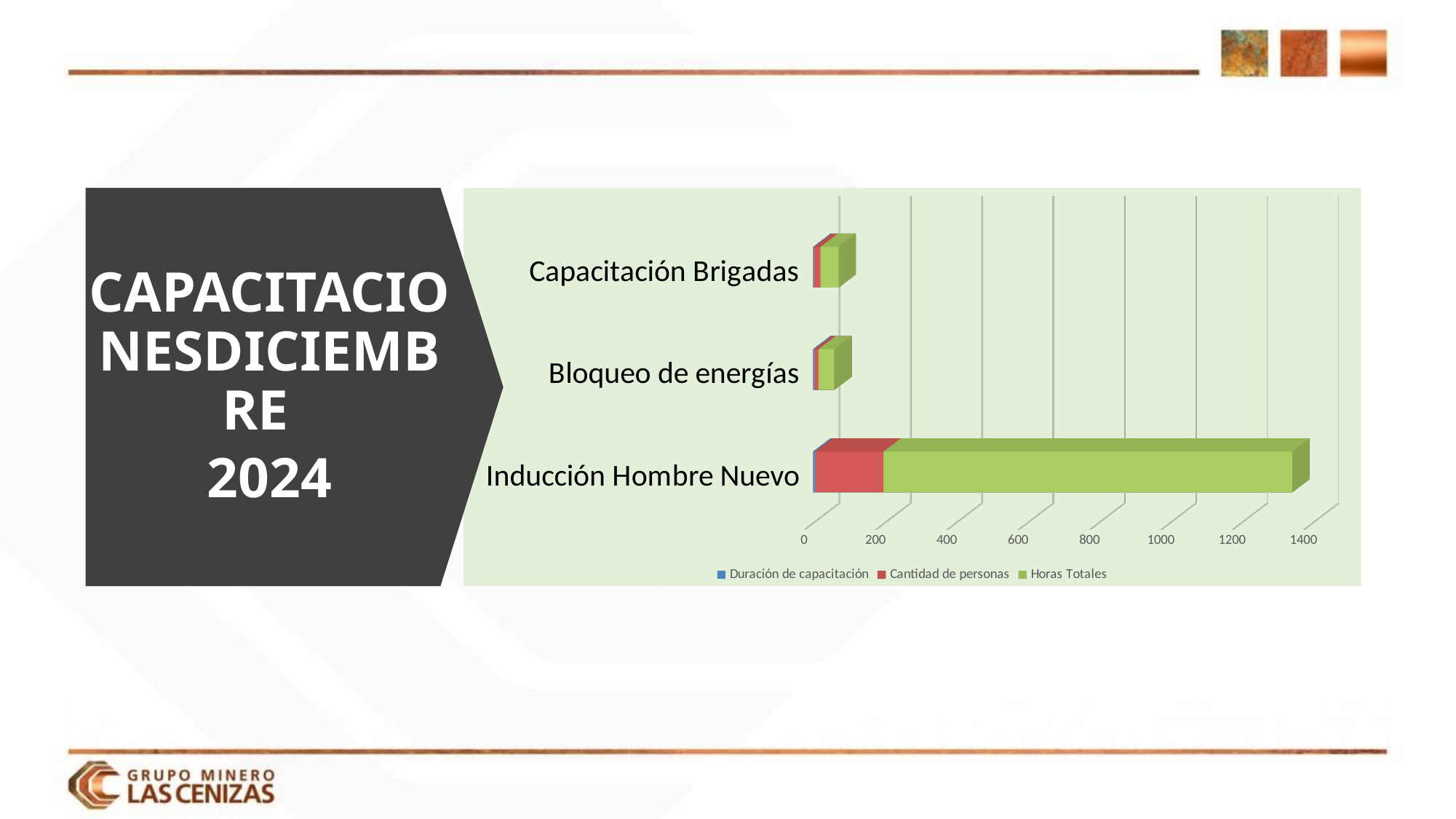
How many series does the chart legend list? 3 Which has the larger total bar, Inducción Hombre Nuevo or Bloqueo de energías? Inducción Hombre Nuevo Is the total bar length for Bloqueo de energías greater or less than 200? less What are the three series listed in the chart legend? Duración de capacitación, Cantidad de personas, Horas Totales Which category has the longest bar on the chart? Inducción Hombre Nuevo What kind of chart is shown on the slide? Stacked bar chart Is the total bar length for Inducción Hombre Nuevo greater or less than 1000? greater Which series is shown in green on the chart? Horas Totales How many categories are plotted on the chart? 3 Is the total bar length for Capacitación Brigadas greater or less than 200? less Which has the larger total bar, Inducción Hombre Nuevo or Capacitación Brigadas? Inducción Hombre Nuevo